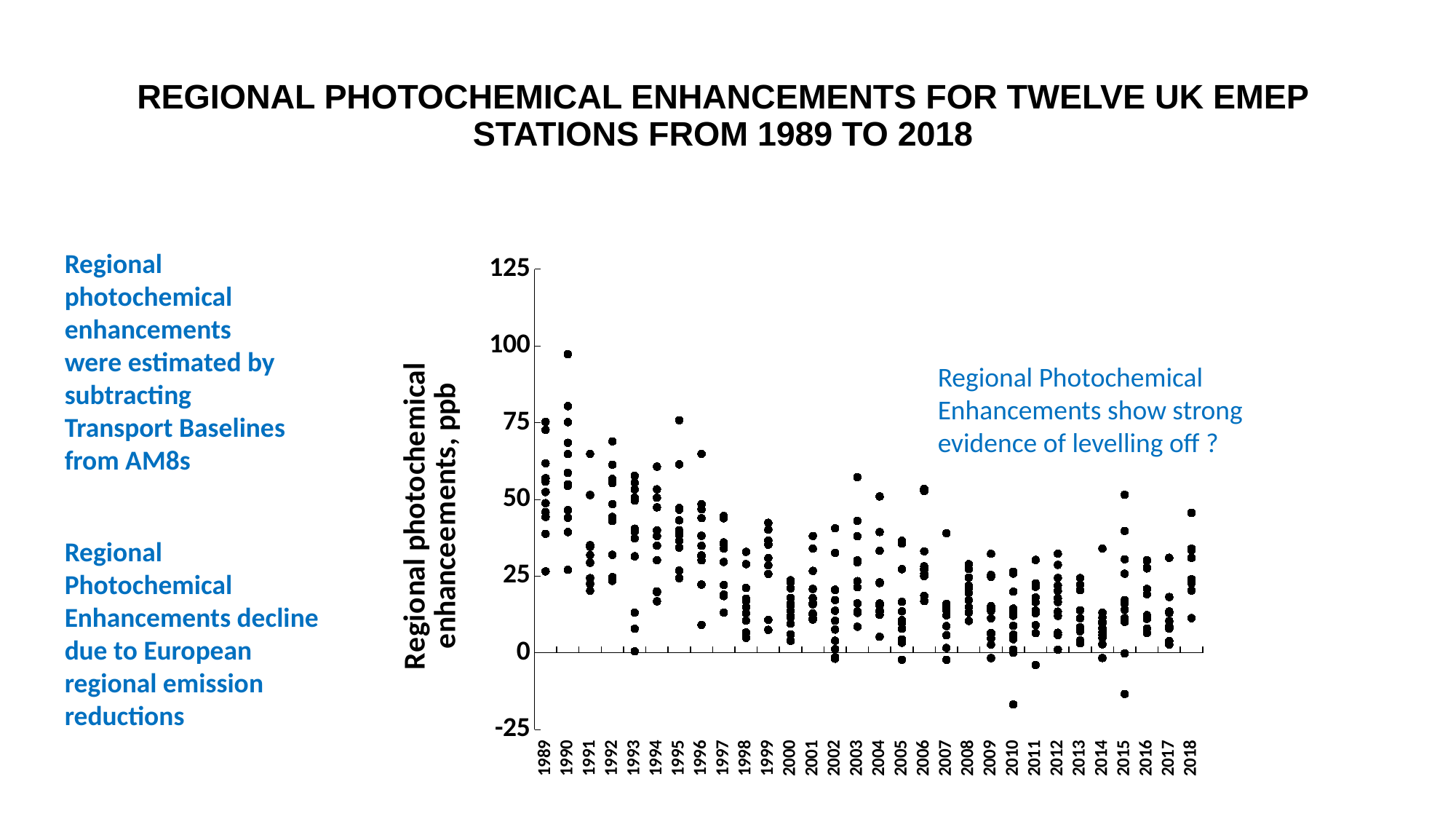
Is the highest value plotted for 2010 greater or less than 50? less What is the label of the y axis of the chart? Regional photochemical enhanceements, ppb Is the highest value plotted for 1990 greater or less than 75? greater What kind of chart is shown on the slide? scatter chart Do the regional photochemical enhancement values generally rise or fall from 1989 to 2018? fall Is the highest value plotted for 1989 greater or less than 50? greater What is the highest tick value shown on the y axis? 125 Which year contains the highest single plotted value? 1990 How many years are shown along the x axis of the chart? 30